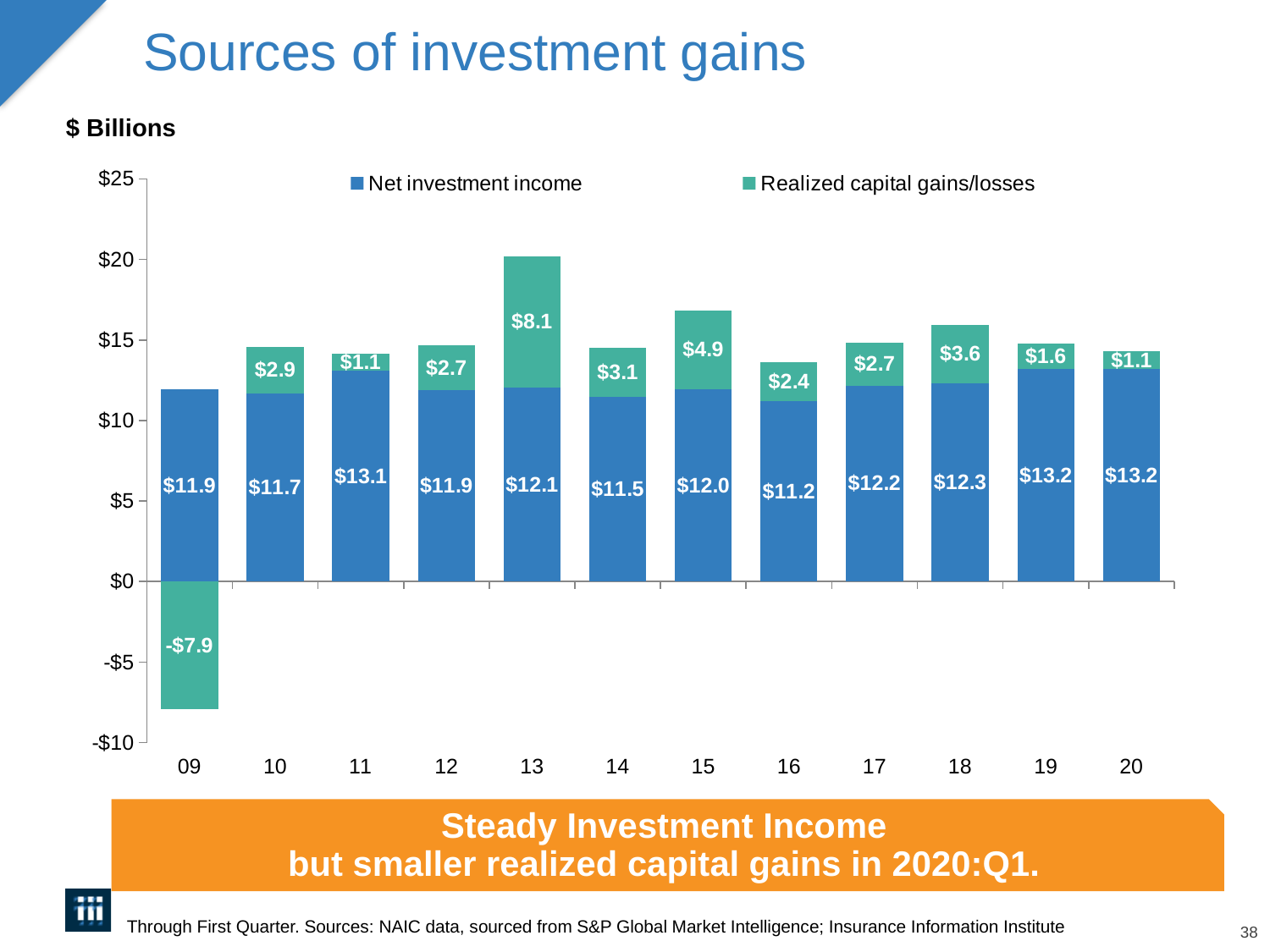
How many series does the legend list? 2 How many years are shown on the x axis? 12 Which year has the lowest net investment income? 16 What are the realized capital gains/losses for 2009? -$7.9 Which year has the highest realized capital gains? 13 What is the net investment income for 2013? $12.1 What are the realized capital gains/losses for 2020? $1.1 Which is larger, net investment income in 2011 or in 2014? 2011 What is the difference between realized capital gains in 2015 and 2016? $2.5 What is the total of the stacked bar for 2013? $20.2 What is the title of the chart? Sources of investment gains What kind of chart is shown on the slide? Stacked bar chart